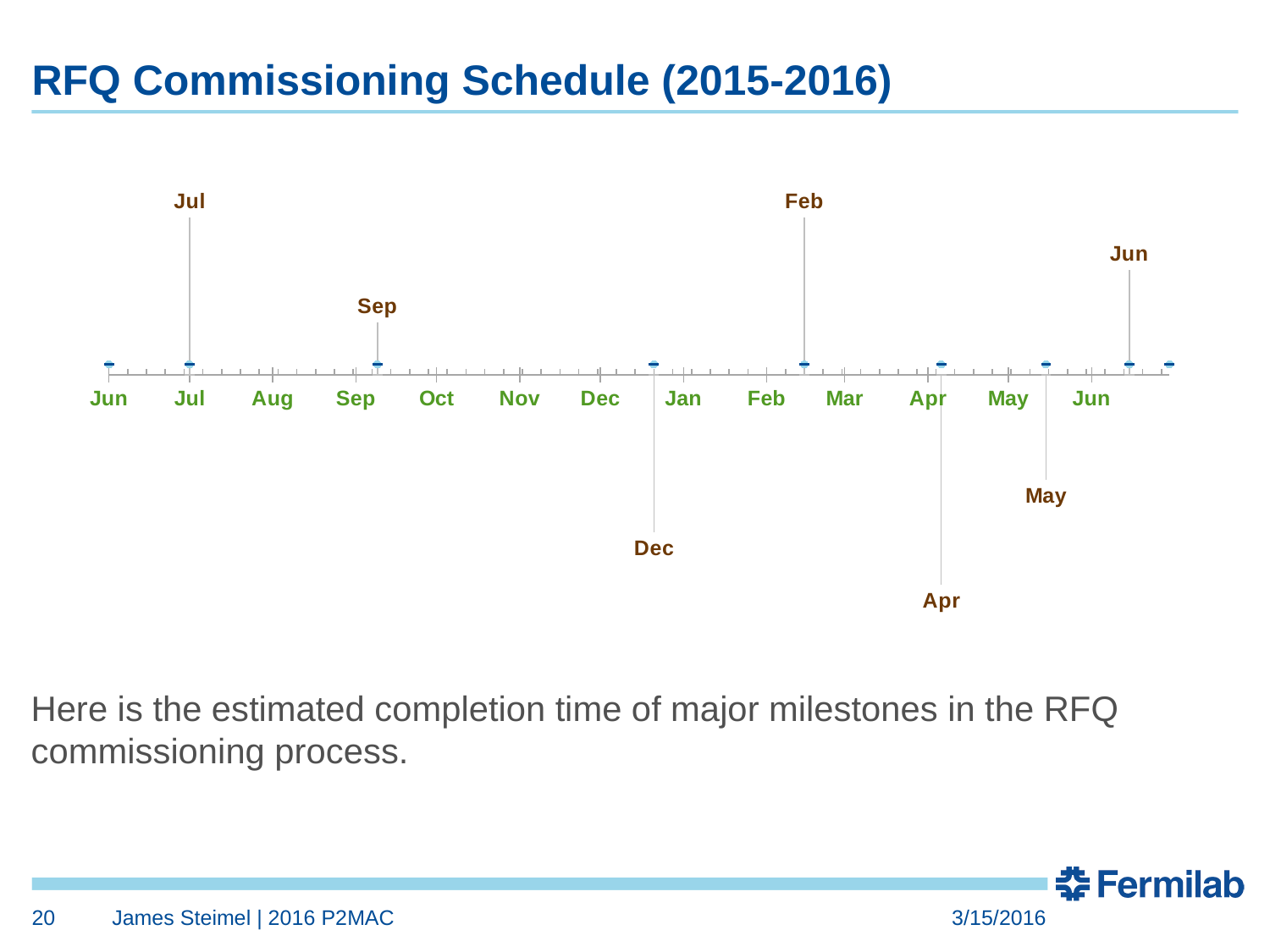
Which milestone comes immediately after the Sep milestone on the timeline? Dec Which milestone comes immediately before the Feb milestone on the timeline? Dec Which month label starts the timeline axis? Jun Is there a labeled milestone in Oct on the timeline? No Which milestone labels are placed below the timeline axis? Dec, Apr, May What kind of chart is shown on the slide? A timeline chart How many month labels appear along the timeline axis? 13 Which month is the last labeled milestone on the timeline? Jun Which milestone labels are placed above the timeline axis? Jul, Sep, Feb, Jun Which month is the first labeled milestone on the timeline? Jul What is the title of the chart on the slide? RFQ Commissioning Schedule (2015-2016) How many labeled milestones are marked on the timeline? 7